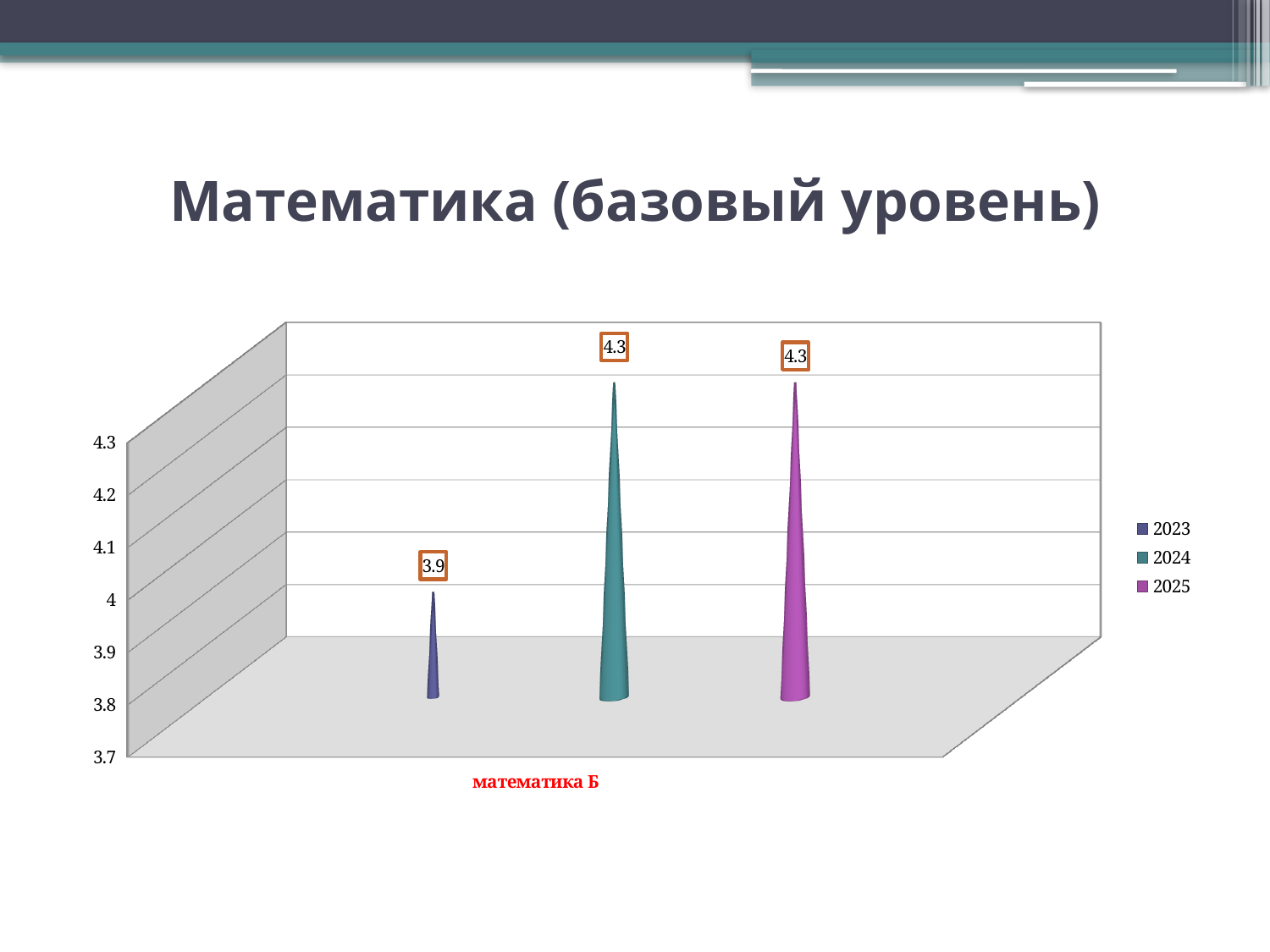
What kind of chart is shown on the slide? bar chart Which is larger, the value for 2023 or the value for 2024? 2024 How many series does the legend list? 3 What is the value for 2024 in the chart? 4.3 What is the value for 2025 in the chart? 4.3 Which year has the lowest value in the chart? 2023 Is the value for 2023 greater or less than 4? less How many categories are shown on the x axis? 1 What is the title of the slide? Математика (базовый уровень) What is the value for 2023 in the chart? 3.9 What is the difference between the value for 2024 and the value for 2023? 0.4 What is the category label shown on the x axis? математика Б